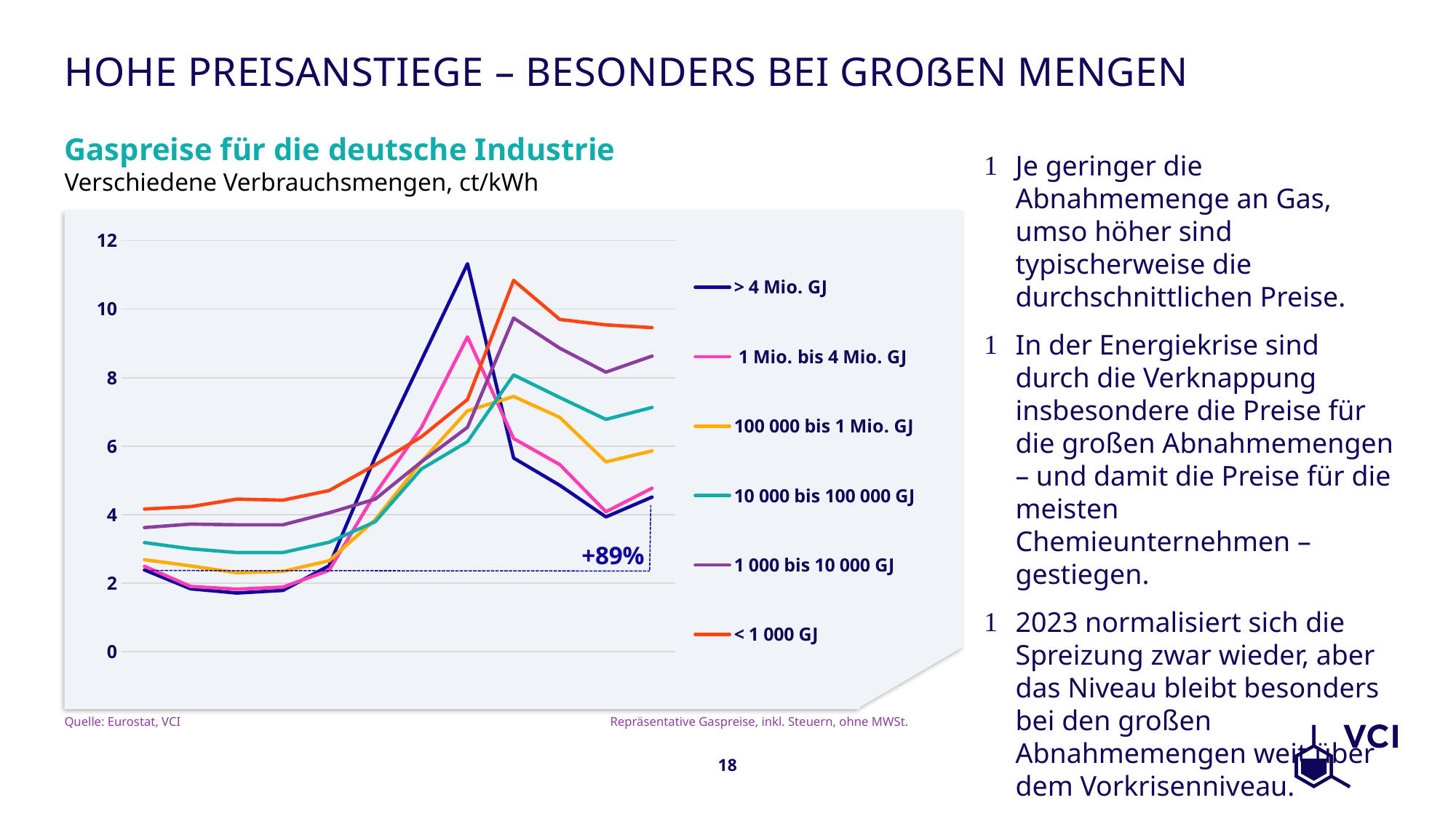
Is the value of the '< 1 000 GJ' series at the last point on the x axis greater or less than 8? greater Is the peak value of the '1 Mio. bis 4 Mio. GJ' series greater or less than 10? less What kind of chart is shown on the slide? line chart Which series has the highest value at the last point on the x axis? < 1 000 GJ Is the peak value of the '> 4 Mio. GJ' series greater or less than 10? greater Which series reaches the highest value anywhere on the chart? > 4 Mio. GJ What is the title of the chart? Gaspreise für die deutsche Industrie Which series is drawn in orange in the chart? < 1 000 GJ At the point where the '> 4 Mio. GJ' series peaks, which is higher, '> 4 Mio. GJ' or '< 1 000 GJ'? > 4 Mio. GJ How many series does the legend of the chart list? 6 What percentage increase is annotated on the chart for the '> 4 Mio. GJ' series? +89%